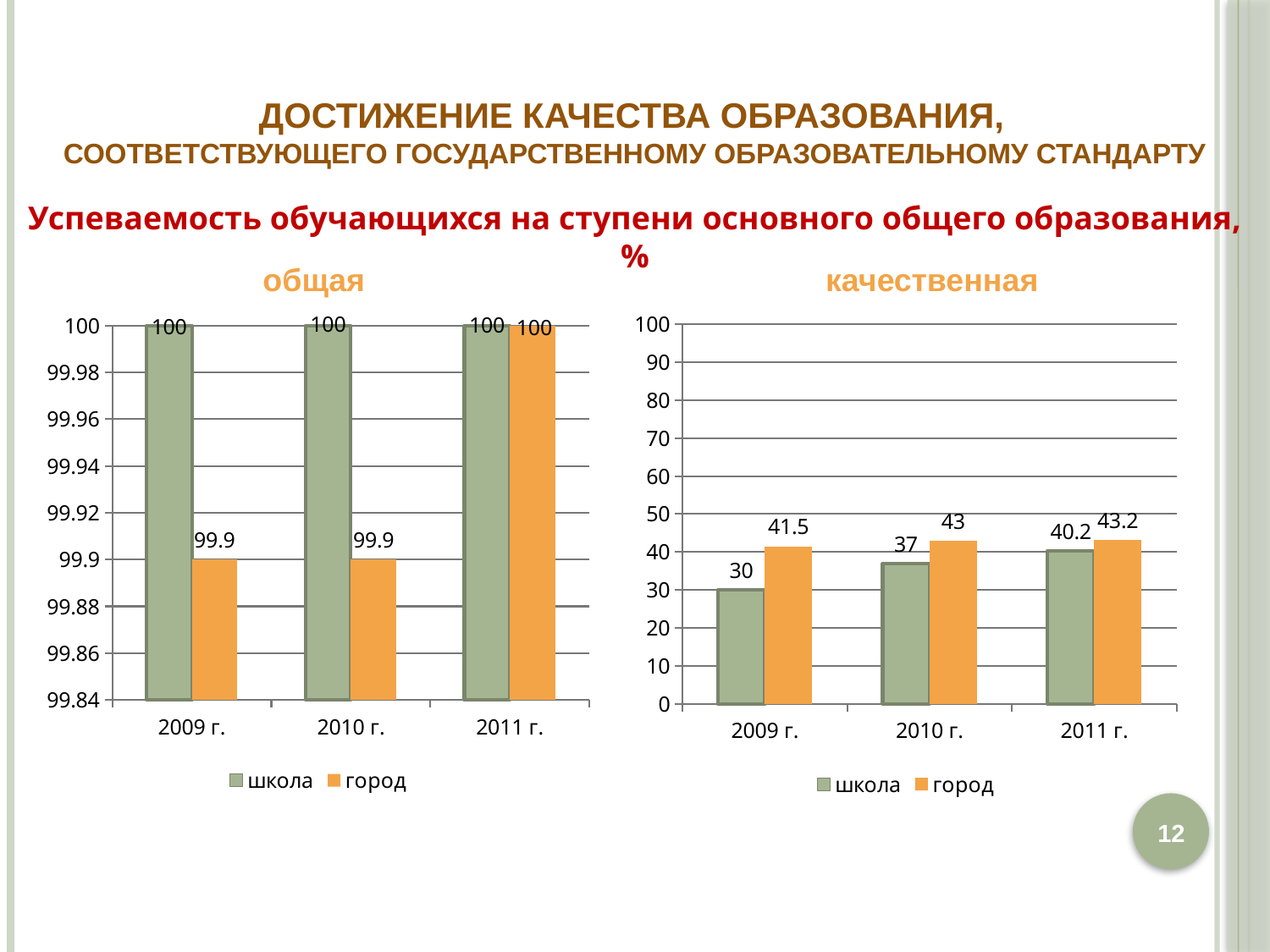
In the 'качественная' chart, is the value for школа in 2011 г. greater or less than 50? less In the 'качественная' chart, what is the value for город in 2011 г.? 43.2 How many series does the legend of the 'общая' chart list? 2 In the 'общая' chart, what is the value for город in 2010 г.? 99.9 In the 'общая' chart, which is larger in 2009 г., школа or город? школа In the 'качественная' chart, which year has the lowest value for школа? 2009 г. In the 'качественная' chart, which year has the highest value for город? 2011 г. In the 'качественная' chart, do the values for школа rise or fall from 2009 г. to 2011 г.? rise In the 'качественная' chart, what is the difference between город and школа in 2010 г.? 6 How many years are shown on the x axis of the 'качественная' chart? 3 In the 'качественная' chart, what is the value for школа in 2009 г.? 30 In the 'качественная' chart, what is the difference between город and школа in 2009 г.? 11.5